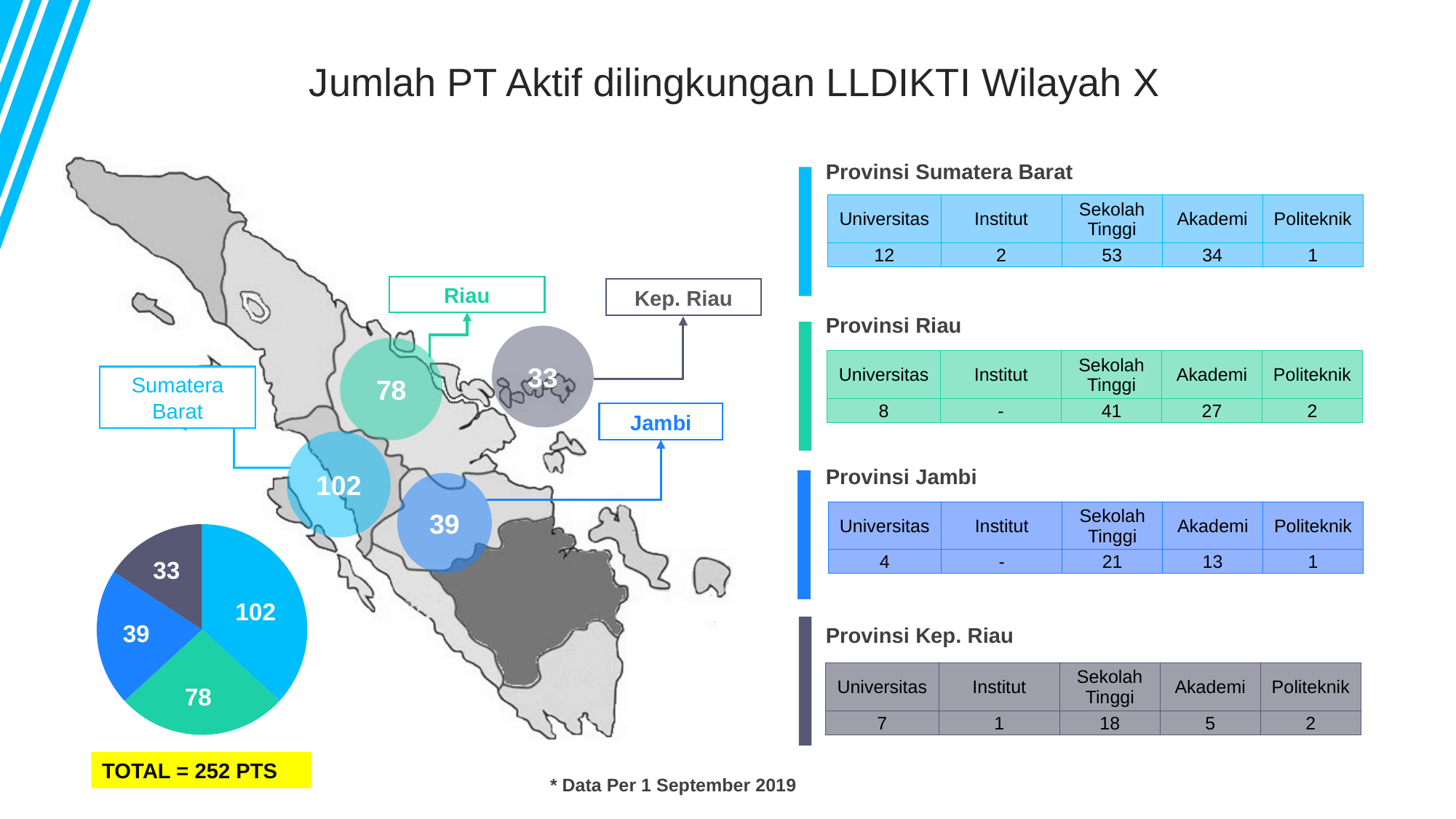
What is the smallest value shown in the pie chart? 33 What is the largest value shown in the pie chart? 102 What is the difference between the 78 slice and the 39 slice in the pie chart? 39 What kind of chart is shown at the bottom left of the slide? pie chart What is the value of the green slice in the pie chart? 78 What is the value of the dark blue slice in the pie chart? 39 How many slices does the pie chart have? 4 According to the map bubbles, which province has the value 102? Sumatera Barat Which is larger in the pie chart, the light blue slice or the green slice? the light blue slice (102) What is the difference between the largest and smallest slices in the pie chart? 69 According to the map bubbles, what is the value for Kep. Riau? 33 What is the total of all slices in the pie chart, as stated on the slide? 252 PTS